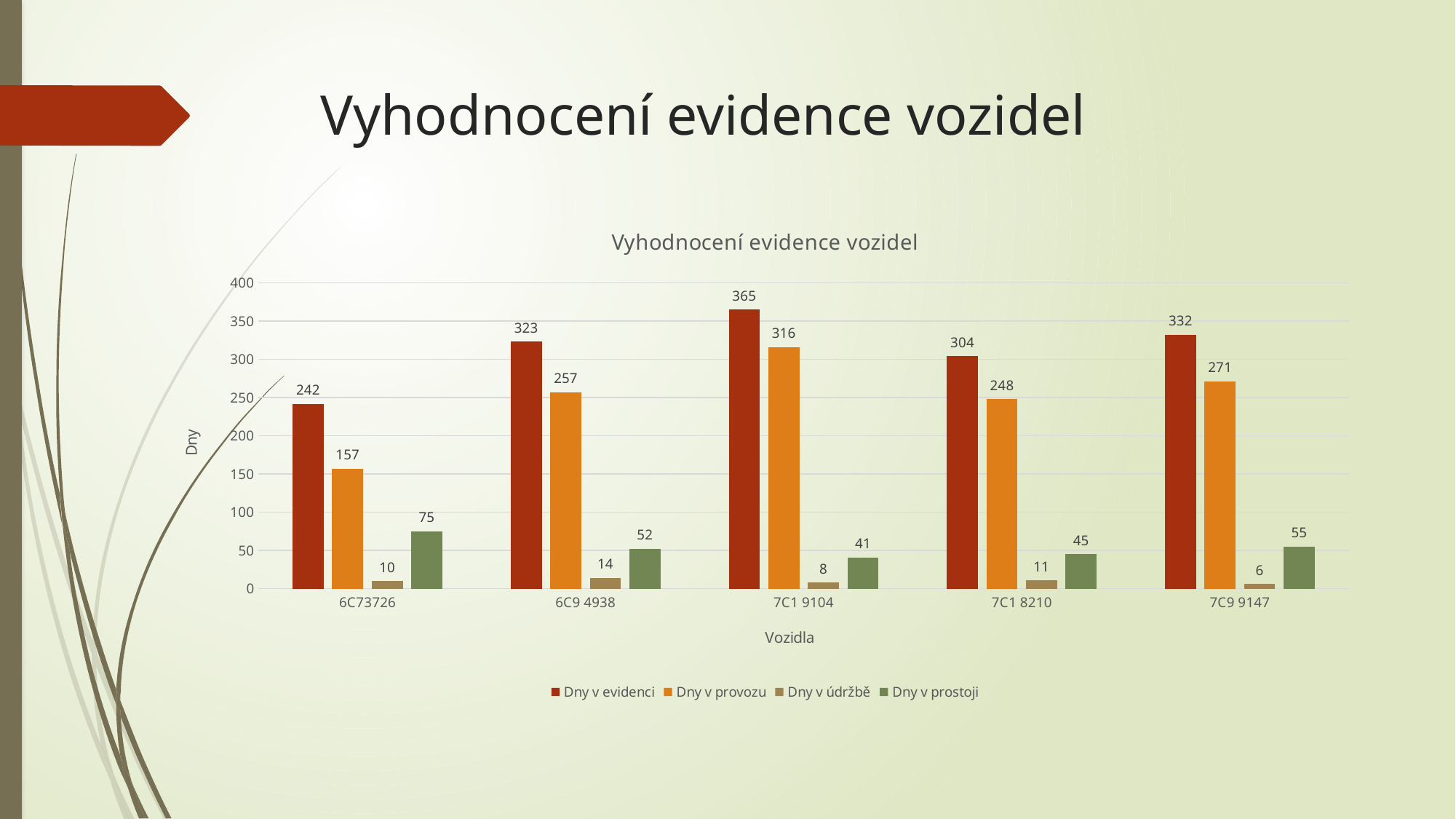
What is the difference between "Dny v evidenci" and "Dny v provozu" for vehicle 7C1 8210? 56 Which vehicle has the highest value for "Dny v evidenci"? 7C1 9104 What is the value of "Dny v údržbě" for vehicle 6C9 4938? 14 What kind of chart is shown on the slide? Bar chart How many series does the legend list? 4 What is the value of "Dny v evidenci" for vehicle 7C1 9104? 365 Which is larger: "Dny v prostoji" for 6C73726 or for 6C9 4938? 6C73726 How many vehicles are shown on the x axis? 5 What is the value of "Dny v provozu" for vehicle 6C73726? 157 Which vehicle has the lowest value for "Dny v údržbě"? 7C9 9147 What is the label of the y axis? Dny What is the value of "Dny v prostoji" for vehicle 7C9 9147? 55